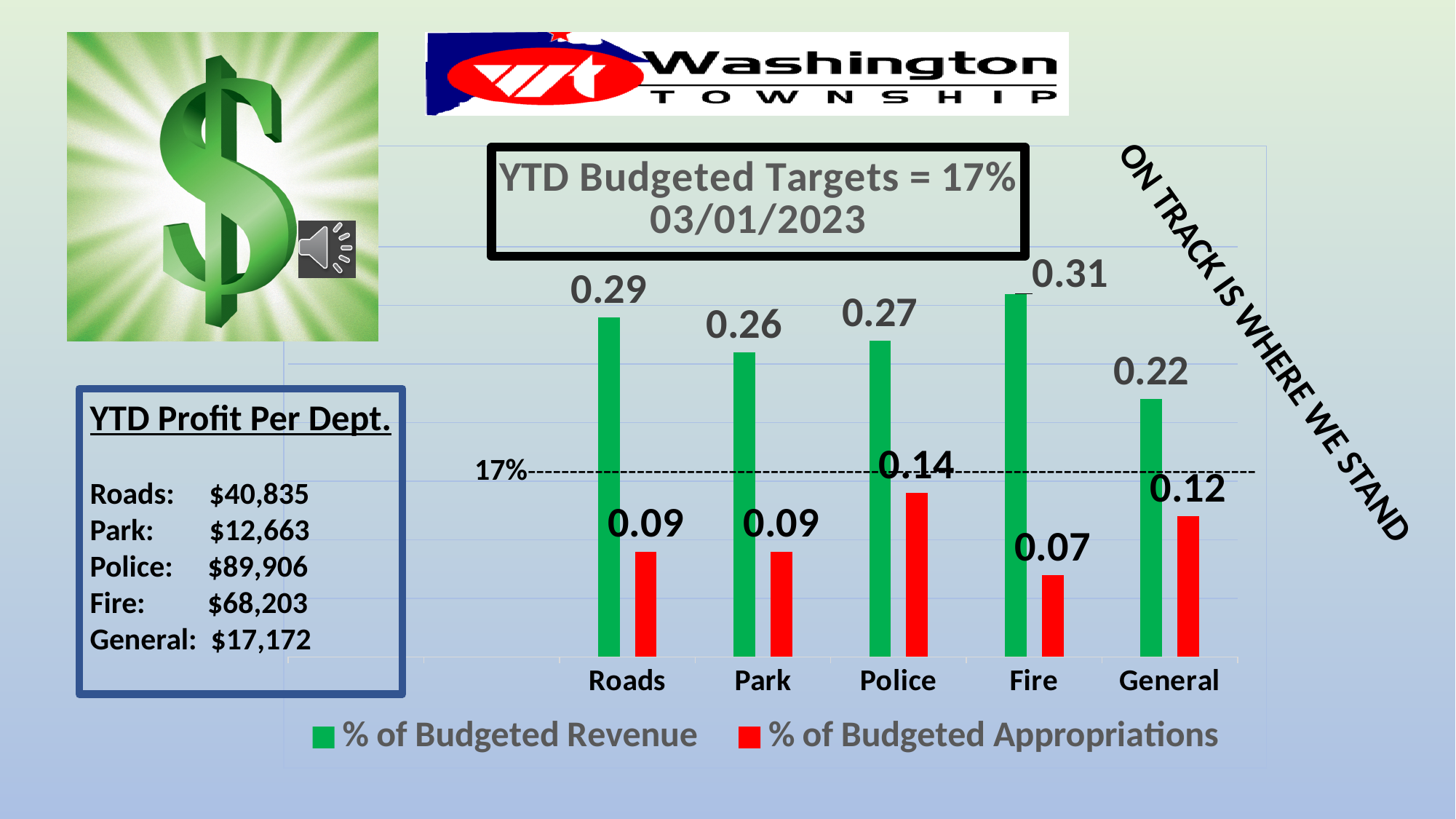
Which department has the highest % of Budgeted Revenue? Fire How many departments are shown on the x axis of the chart? 5 What is the % of Budgeted Revenue value for Fire? 0.31 What value does the dashed horizontal target line on the chart mark? 17% What is the % of Budgeted Appropriations value for Police? 0.14 What is the % of Budgeted Revenue value for General? 0.22 Which department has the lowest % of Budgeted Appropriations? Fire How many series does the chart legend list? 2 Which is larger, the % of Budgeted Appropriations for General or for Park? General What kind of chart is shown on the slide? Bar chart Which colour represents % of Budgeted Appropriations in the chart legend? Red What is the difference between the % of Budgeted Revenue and the % of Budgeted Appropriations for Roads? 0.20